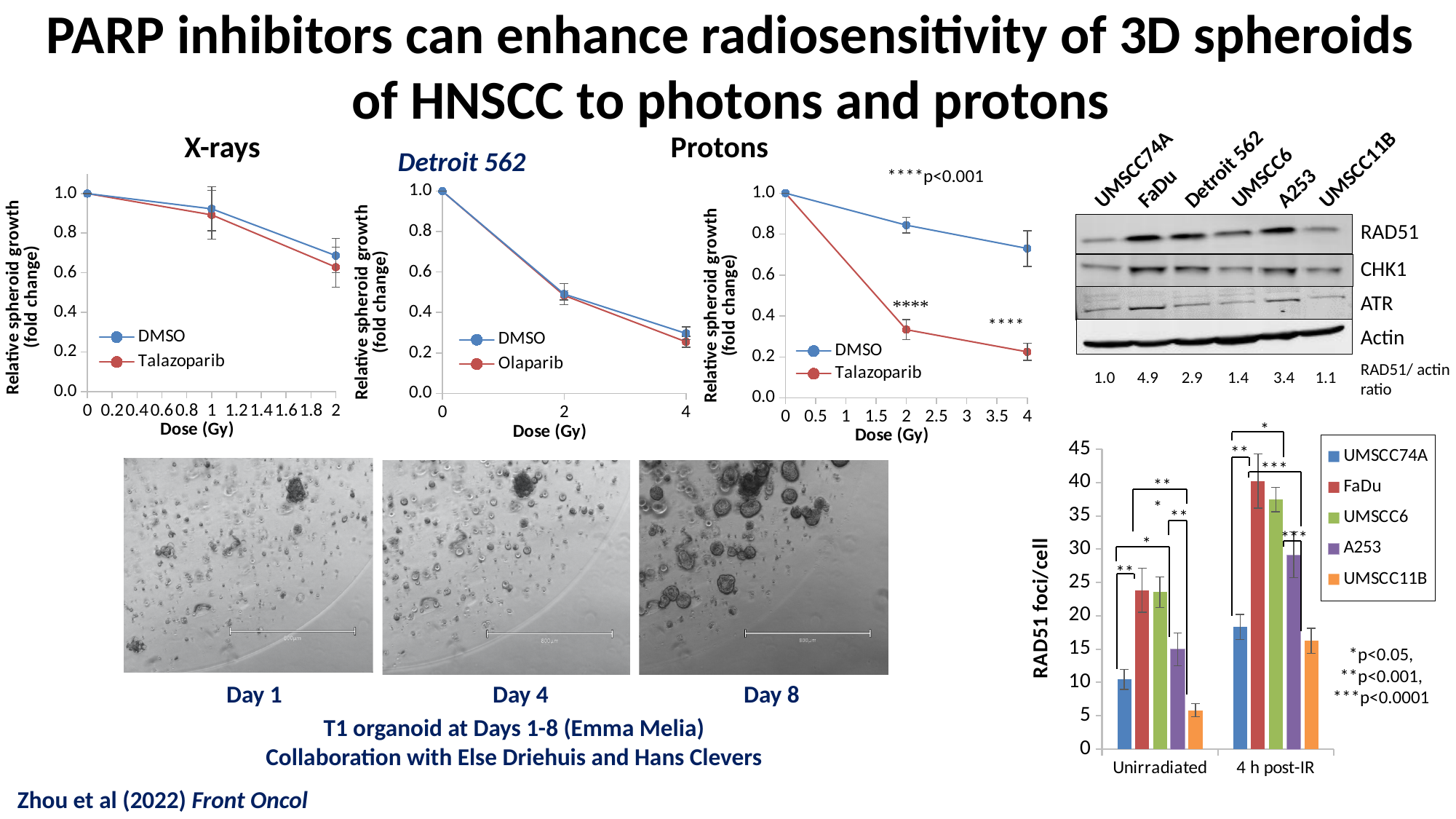
In the 'Detroit 562' chart, how many dose points are plotted for each series? 3 In the 'X-rays' chart, what is the relative spheroid growth for DMSO at a dose of 0 Gy? 1.0 In the RAD51 foci/cell bar chart, how many series does the legend list? 5 In the RAD51 foci/cell bar chart, which cell line has the lowest value in the Unirradiated group? UMSCC11B In the 'Protons' chart, how many series does the legend list? 2 What kind of chart is the 'Protons' chart? line chart In the 'Protons' chart, which series has the larger value at 4 Gy, DMSO or Talazoparib? DMSO In the 'Protons' chart, is the value for Talazoparib at 2 Gy greater or less than 0.4? less In the RAD51 foci/cell bar chart, is the value for FaDu at 4 h post-IR greater or less than 35? greater In the 'Detroit 562' chart, which two series are listed in the legend? DMSO and Olaparib In the 'Detroit 562' chart, do the values rise or fall as the dose increases? fall In the 'X-rays' chart, is the value for DMSO at 2 Gy greater or less than 0.6? greater